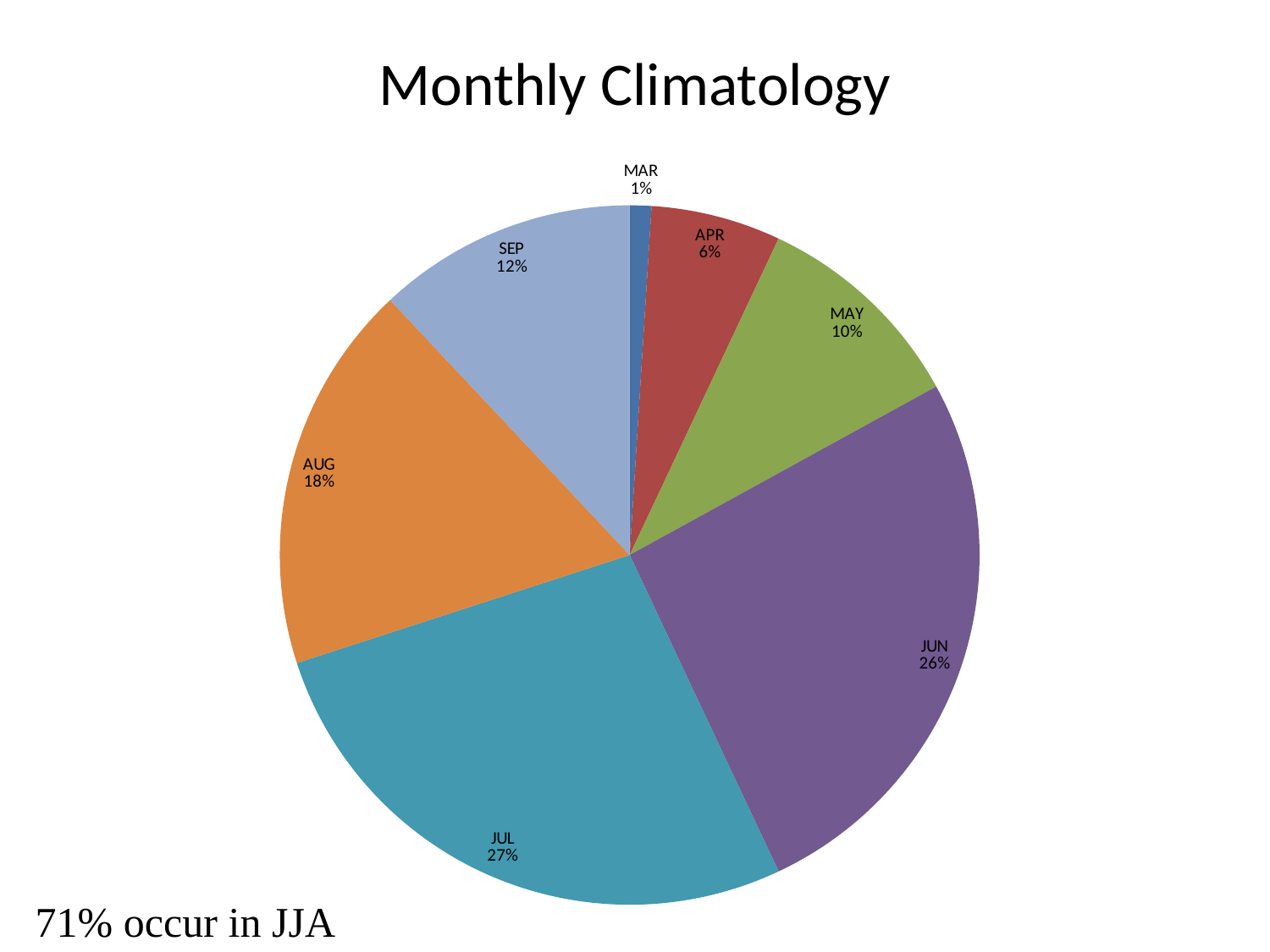
Which month has the smallest slice of the pie? MAR What is the value shown for SEP? 12% Which month has the largest slice of the pie? JUL What is the value shown for APR? 6% Which is larger, the slice for APR or the slice for MAY? MAY What share of the pie does JUL account for? 27% What is the difference between the JUN and MAY percentages? 16% What kind of chart is shown on the slide? Pie chart What is the value shown for AUG? 18% How many months are shown in the pie chart? 7 What is the combined share of JUN, JUL and AUG? 71% What is the title of the chart? Monthly Climatology